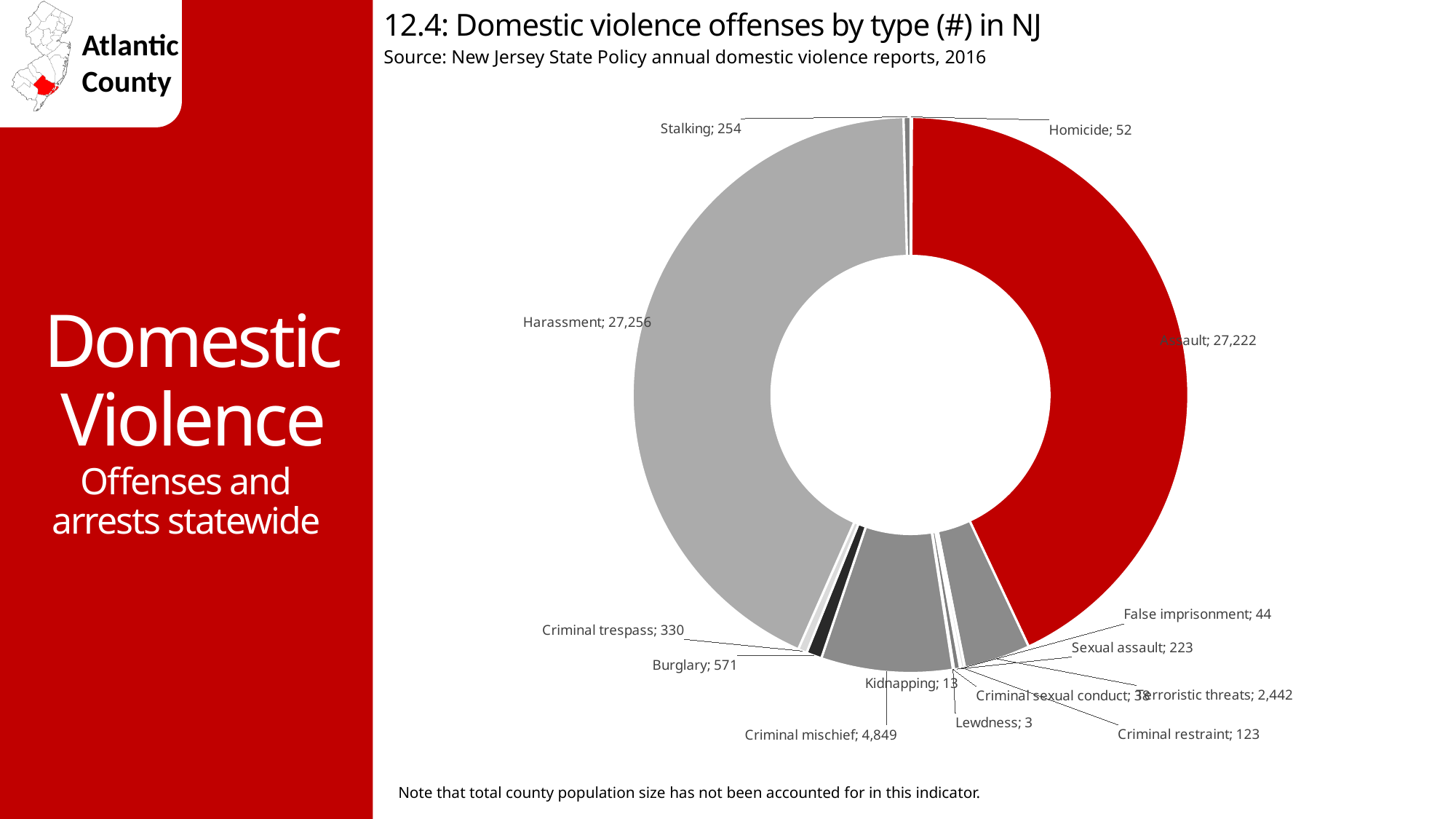
What is the difference between the values for Burglary and Criminal trespass? 241 Which is larger, the value for Stalking or the value for Sexual assault? Stalking What is the value for Kidnapping? 13 What is the value for Criminal mischief? 4,849 Which is larger, the value for Criminal mischief or the value for Terroristic threats? Criminal mischief How many offense types are shown in the chart? 14 How many domestic violence offenses of type Homicide are shown? 52 What is the value for Terroristic threats? 2,442 What is the value for Burglary? 571 What kind of chart is shown on the slide? doughnut chart What is the difference between the values for Harassment and Assault? 34 Which offense type has the lowest value? Lewdness